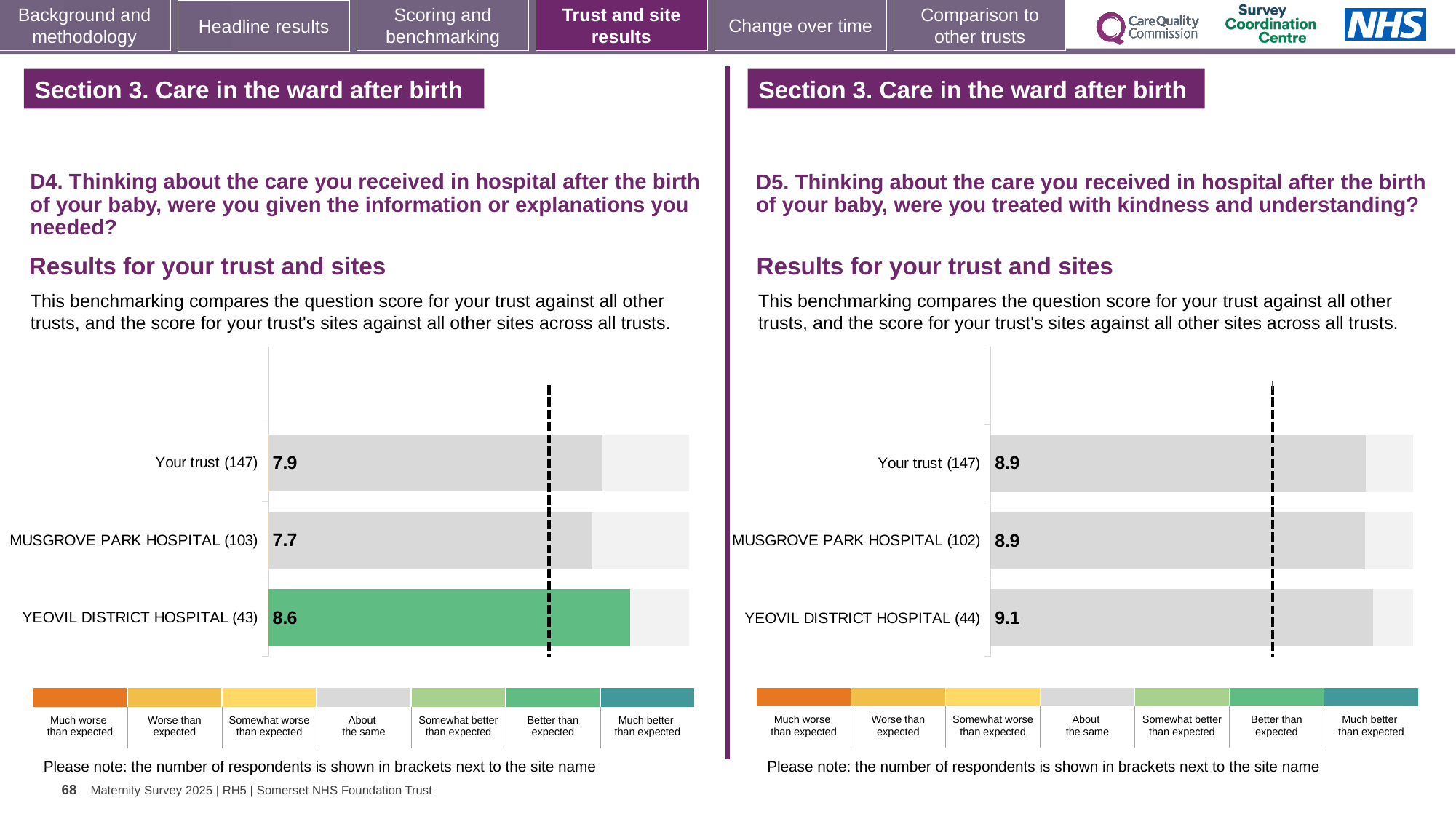
In the D4 chart on the left, which site or trust has the lowest score? MUSGROVE PARK HOSPITAL (103) In the D5 chart on the right, which site or trust has the highest score? YEOVIL DISTRICT HOSPITAL (44) In the D5 chart on the right, what is the score for MUSGROVE PARK HOSPITAL (102)? 8.9 In the D4 chart on the left, which site or trust has the highest score? YEOVIL DISTRICT HOSPITAL (43) In the D5 chart on the right, what is the score for YEOVIL DISTRICT HOSPITAL (44)? 9.1 In the D4 chart on the left, what is the score for YEOVIL DISTRICT HOSPITAL (43)? 8.6 In the D4 chart on the left, what is the score for Your trust (147)? 7.9 How many bars are plotted in the D4 chart on the left? 3 What kind of chart is the D5 chart on the right? Bar chart In the D4 chart on the left, what is the difference between the scores for YEOVIL DISTRICT HOSPITAL (43) and MUSGROVE PARK HOSPITAL (103)? 0.9 In the D5 chart on the right, what is the difference between the scores for YEOVIL DISTRICT HOSPITAL (44) and Your trust (147)? 0.2 In the D4 chart on the left, what is the score for MUSGROVE PARK HOSPITAL (103)? 7.7